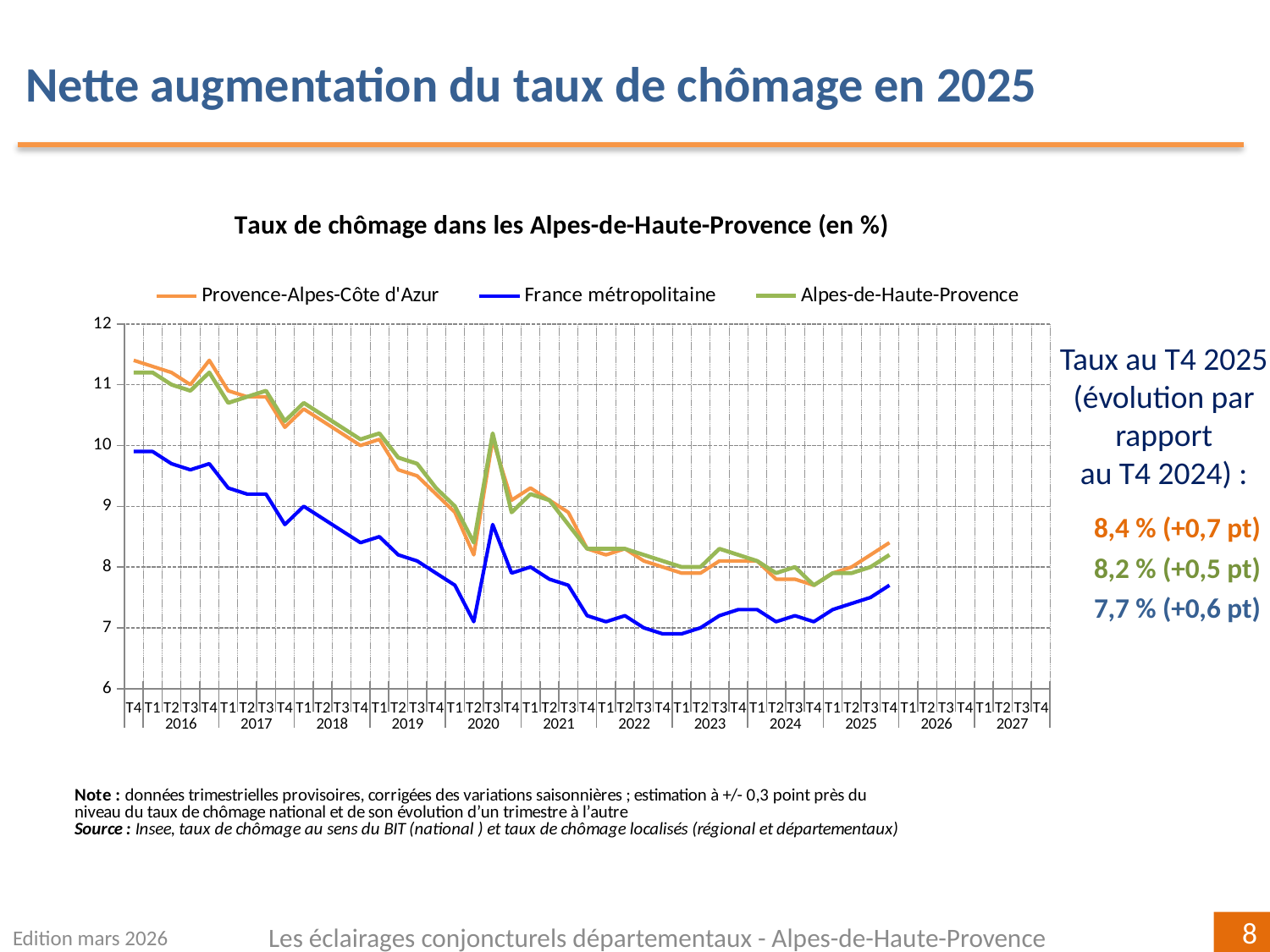
What is the unemployment rate for Provence-Alpes-Côte d'Azur at T4 2025? 8,4 % Which series has the highest value at T4 2025? Provence-Alpes-Côte d'Azur What is the difference between the Provence-Alpes-Côte d'Azur rate and the France métropolitaine rate at T4 2025? 0,7 By how many points did the Alpes-de-Haute-Provence rate change between T4 2024 and T4 2025? +0,5 pt What is the title of the chart? Taux de chômage dans les Alpes-de-Haute-Provence (en %) Which series has the lowest value at T4 2025? France métropolitaine How many series does the legend list? 3 Is the value for France métropolitaine at T4 2015 greater or less than 9? greater What is the unemployment rate for Alpes-de-Haute-Provence at T4 2025? 8,2 % What kind of chart is shown on the slide? line chart Does the France métropolitaine rate rise or fall between 2016 and 2022? fall What is the unemployment rate for France métropolitaine at T4 2025? 7,7 %